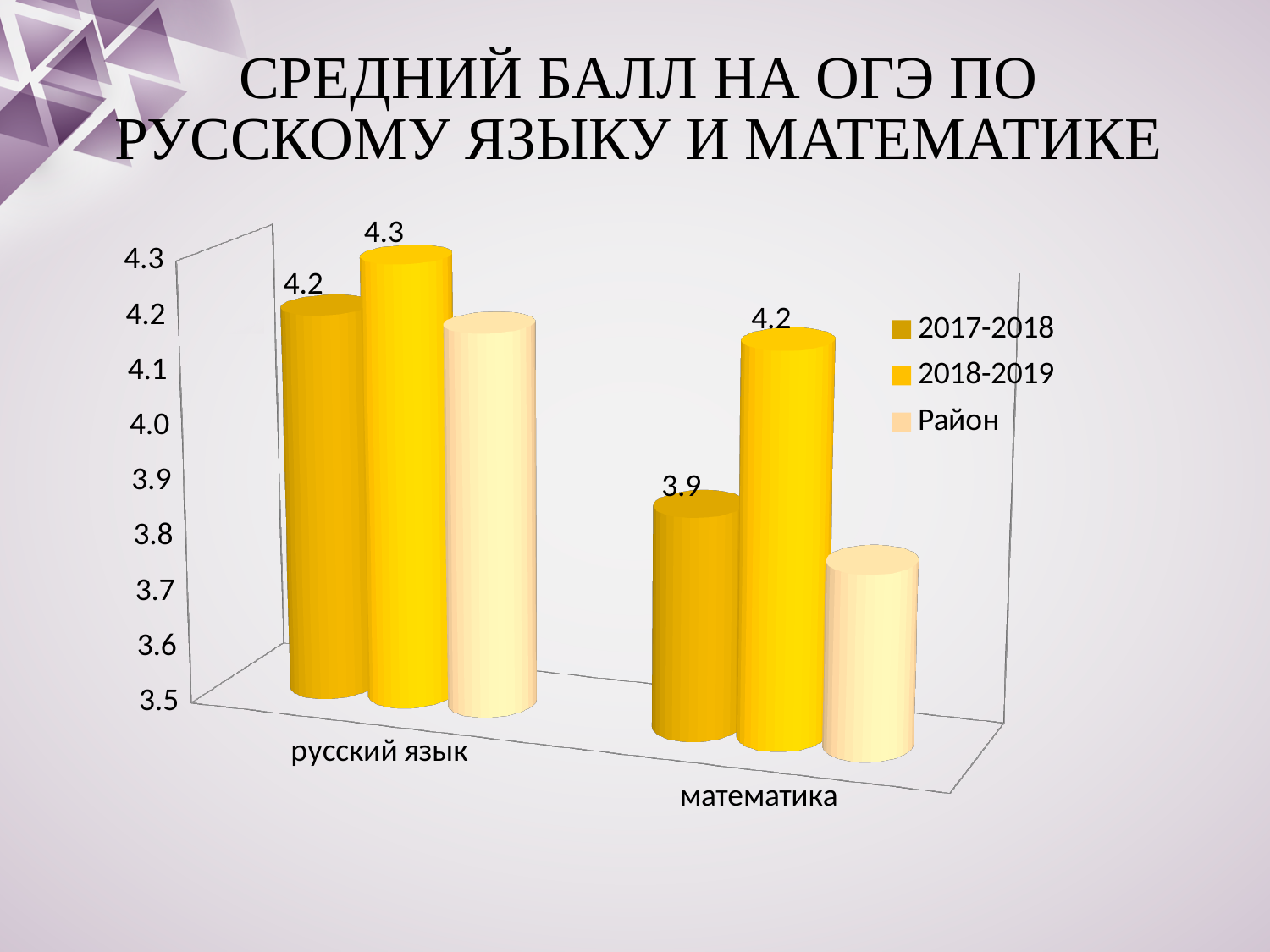
What is the value for 2017-2018 in русский язык? 4.2 Is the value for Район in русский язык greater or less than 4.0? greater What is the value for 2017-2018 in математика? 3.9 What is the value for 2018-2019 in математика? 4.2 What is the difference between the 2018-2019 and 2017-2018 values for русский язык? 0.1 Which series has the highest value in математика? 2018-2019 What is the value for 2018-2019 in русский язык? 4.3 Is the value for Район in математика greater or less than 4.0? less Which is larger for 2017-2018: русский язык or математика? русский язык What is the difference between the 2018-2019 and 2017-2018 values for математика? 0.3 How many series does the legend list? 3 What kind of chart is shown on the slide? bar chart